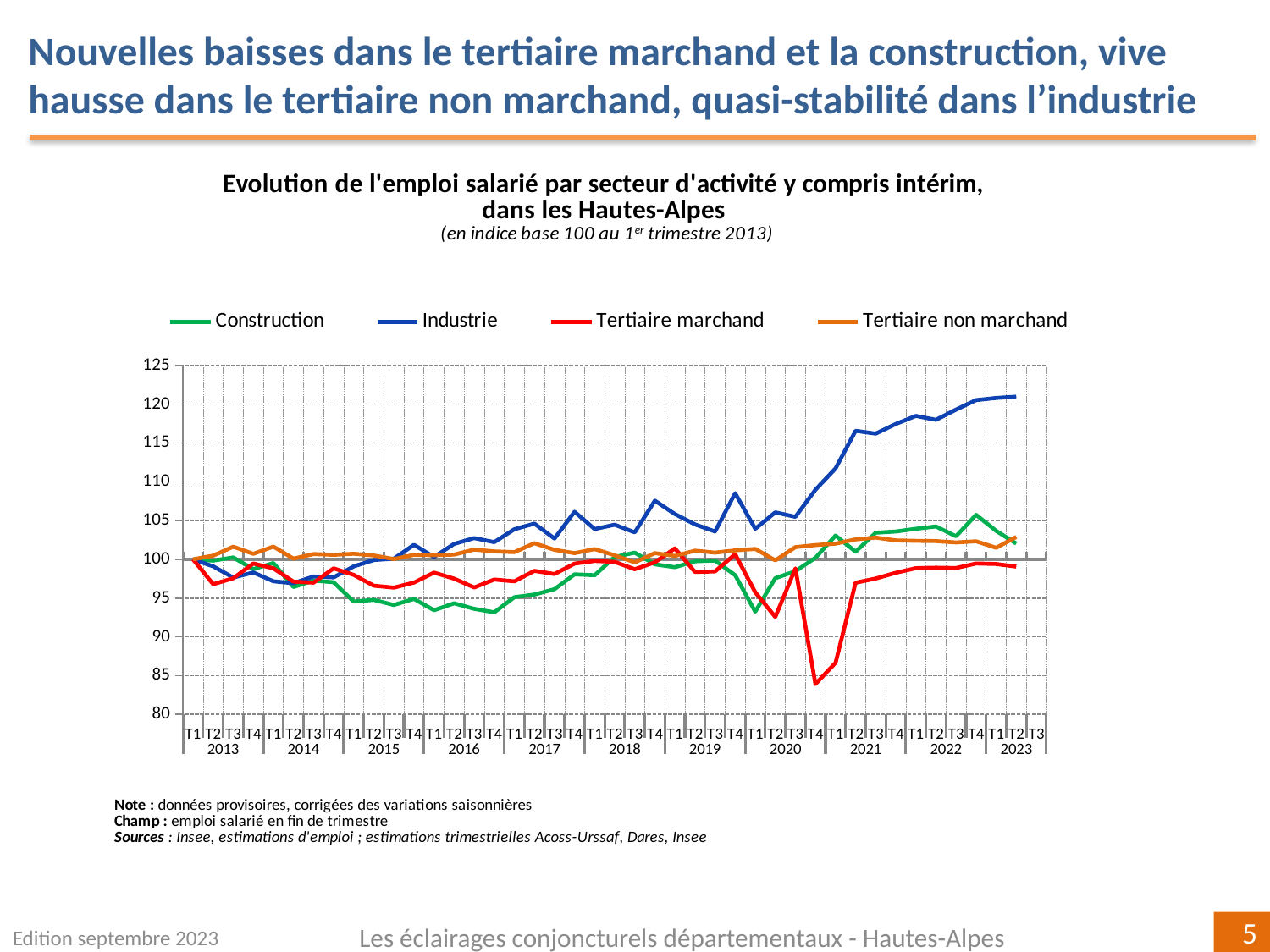
What kind of chart is shown on the slide? line chart At T1 2022, which is larger, Industrie or Construction? Industrie Is the value for Tertiaire marchand at T4 2020 greater or less than 90? less Which series has the lowest value at T4 2020? Tertiaire marchand Is the value for Construction at T1 2020 greater or less than 95? less How many series does the legend list? 4 What is the index value of all series at T1 2013? 100 Which colour is used for the Tertiaire marchand series? red Is the value for Industrie at T1 2021 greater or less than 110? greater